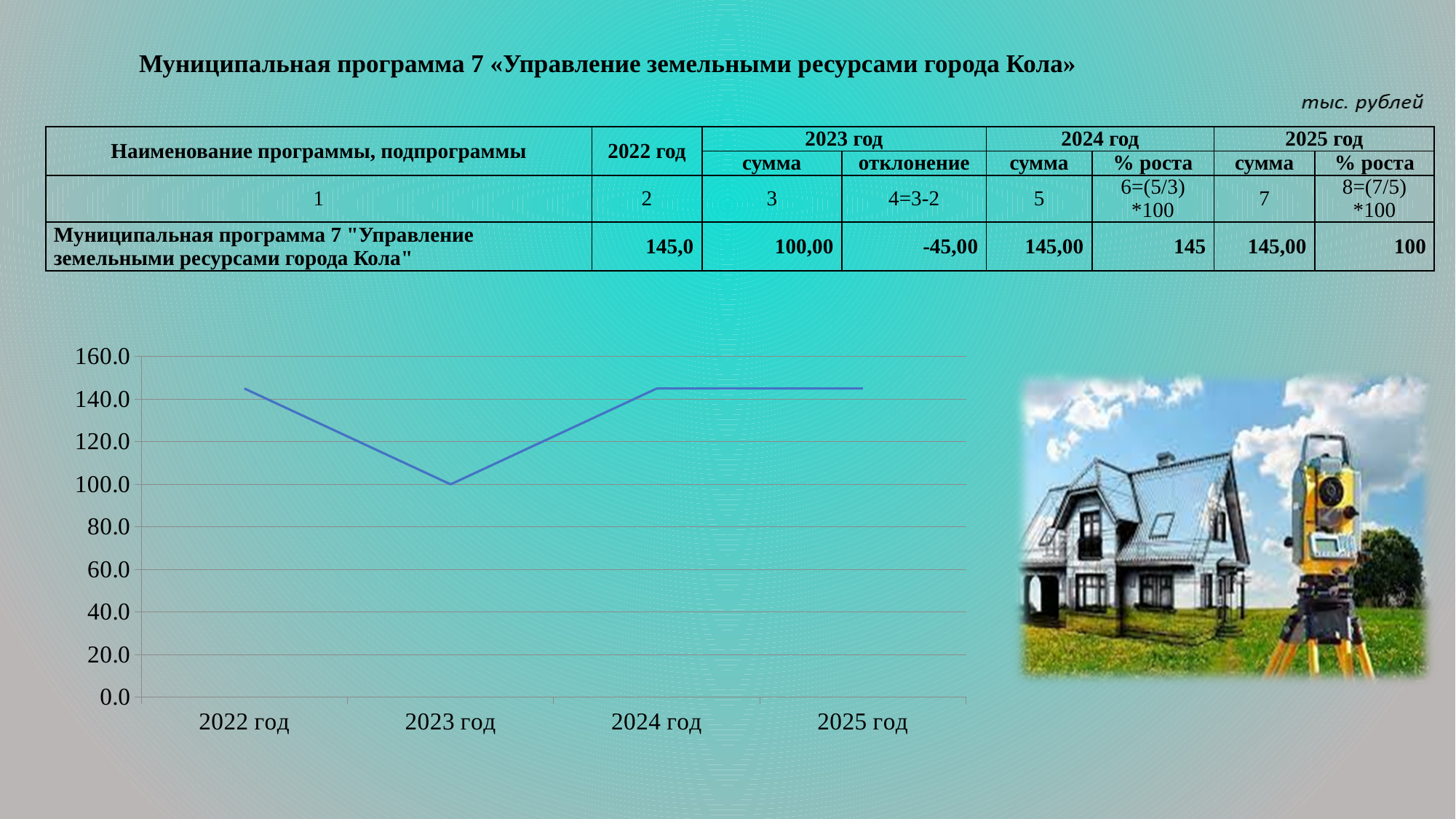
What kind of chart is shown on the slide? line chart What is the value for 2023 год on the line chart? 100.0 Which is larger on the line chart, the value for 2022 год or the value for 2023 год? 2022 год Does the line fall or rise from 2022 год to 2023 год? fall Does the line rise or fall from 2023 год to 2024 год? rise Which year has the lowest value on the line chart? 2023 год Is the value for 2023 год on the line chart greater or less than 120.0? less Is the value for 2024 год on the line chart greater or less than 140.0? greater How many points (years) are plotted on the line chart? 4 Is the value for 2022 год on the line chart greater or less than 140.0? greater What is the highest tick value shown on the vertical axis of the line chart? 160.0